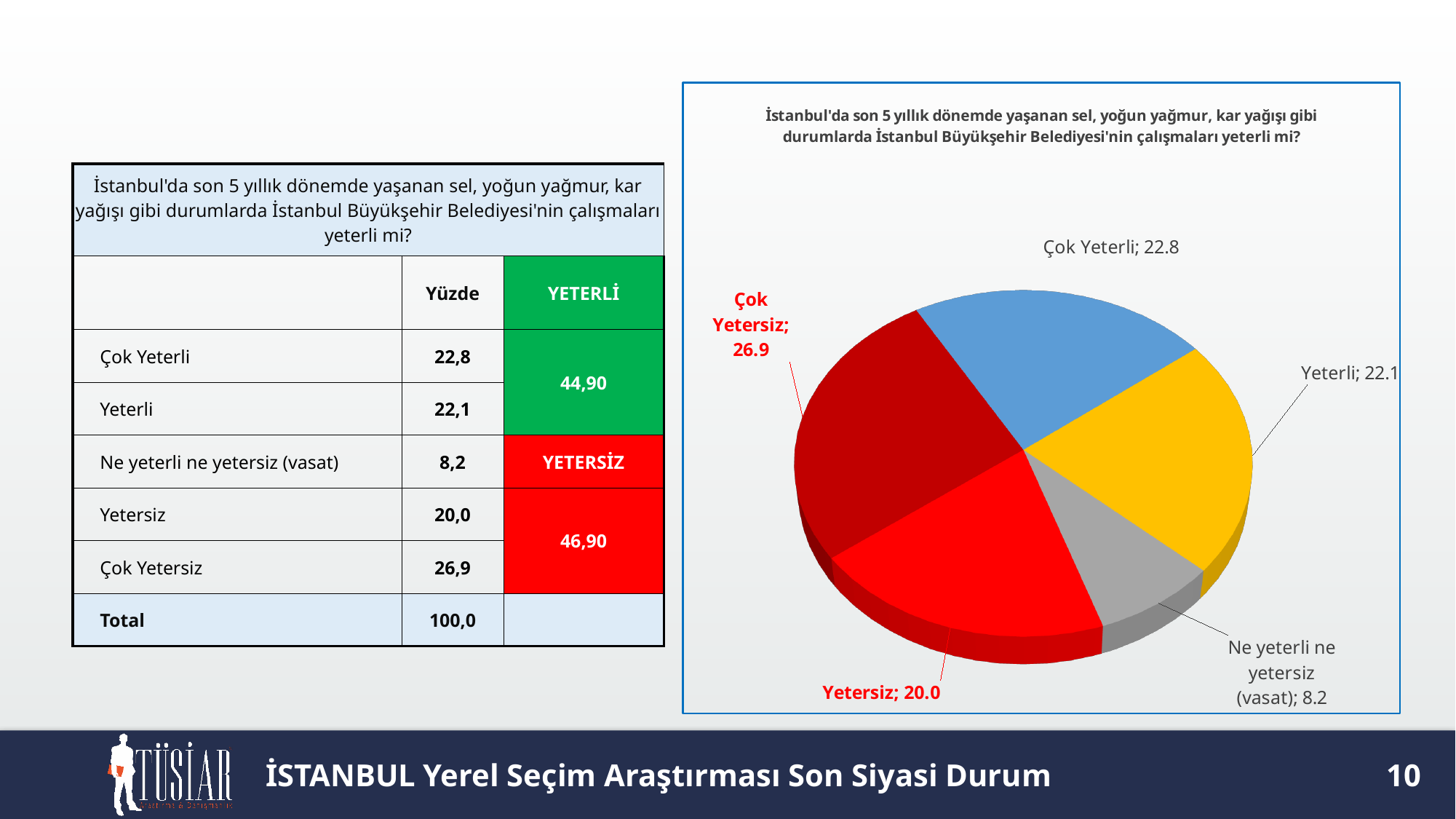
Which category has the smallest slice in the pie chart? Ne yeterli ne yetersiz (vasat) What value is shown for the Yeterli slice in the pie chart? 22.1 Which is larger in the pie chart, Çok Yeterli or Yetersiz? Çok Yeterli Which category has the largest slice in the pie chart? Çok Yetersiz What value is shown for the Çok Yeterli slice in the pie chart? 22.8 What colour is the Yeterli slice in the pie chart? Yellow What value is shown for the Ne yeterli ne yetersiz (vasat) slice in the pie chart? 8.2 What value is shown for the Yetersiz slice in the pie chart? 20.0 How many slices does the pie chart have? 5 What is the difference between the Çok Yetersiz and Çok Yeterli values in the pie chart? 4.1 What type of chart is shown on the slide? Pie chart What value is shown for the Çok Yetersiz slice in the pie chart? 26.9